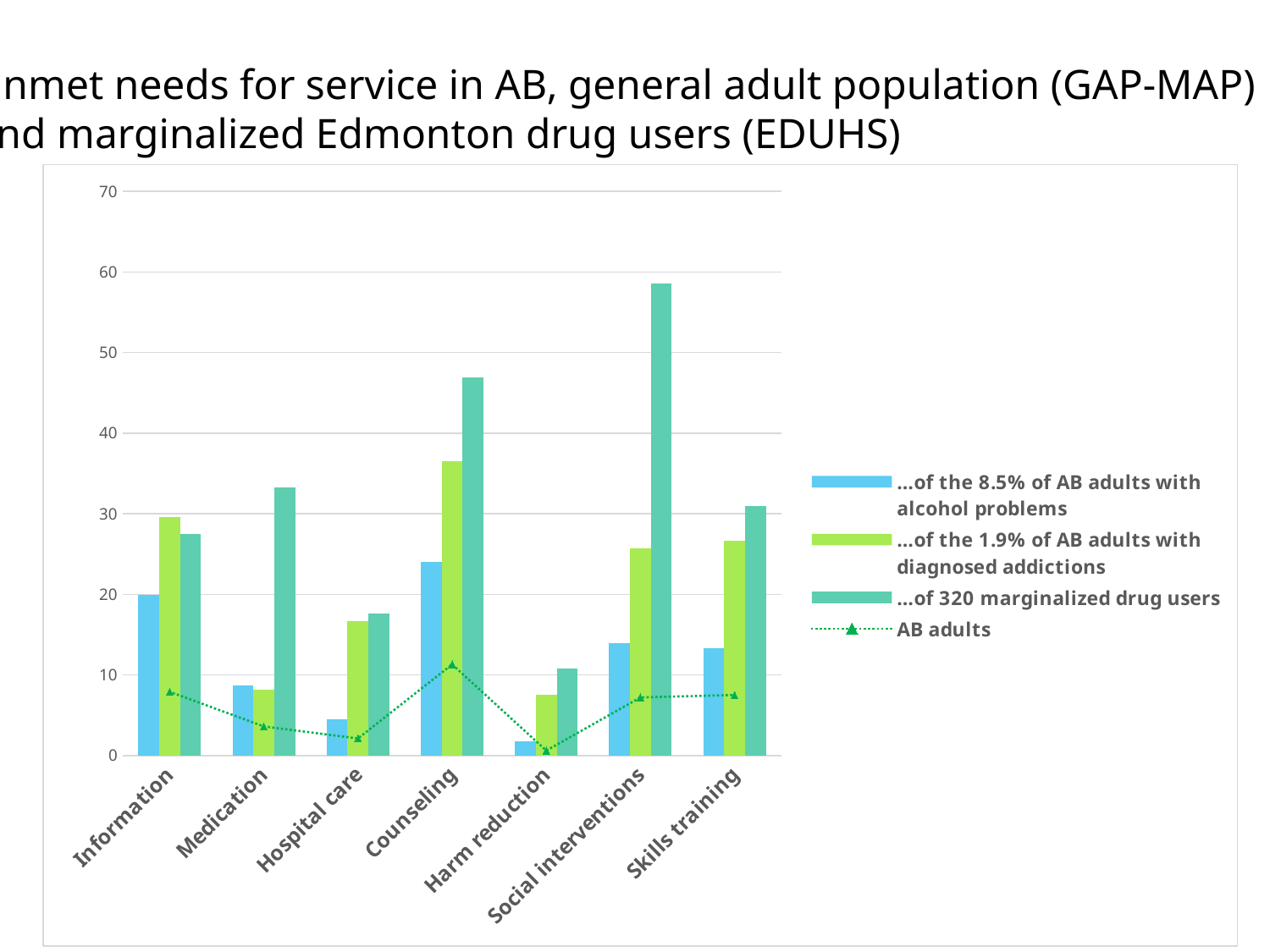
How many service categories are shown on the x axis? 7 How many series does the legend list? 4 Is the value for Counseling in the '...of the 1.9% of AB adults with diagnosed addictions' series greater or less than 30? greater For the '...of 320 marginalized drug users' series, which category has the lowest value? Harm reduction Is the value for Social interventions in the '...of 320 marginalized drug users' series greater or less than 50? greater For the '...of 320 marginalized drug users' series, which category has the highest value? Social interventions For the '...of the 8.5% of AB adults with alcohol problems' series, which category has the highest value? Counseling Is the value for Hospital care in the '...of the 8.5% of AB adults with alcohol problems' series greater or less than 10? less For the '...of the 8.5% of AB adults with alcohol problems' series, which category has the lowest value? Harm reduction What kind of chart is shown on the slide? combination bar and line chart Which series is drawn as a dotted line with triangle markers? AB adults For Medication, which is larger: the value for '...of 320 marginalized drug users' or the value for '...of the 8.5% of AB adults with alcohol problems'? ...of 320 marginalized drug users